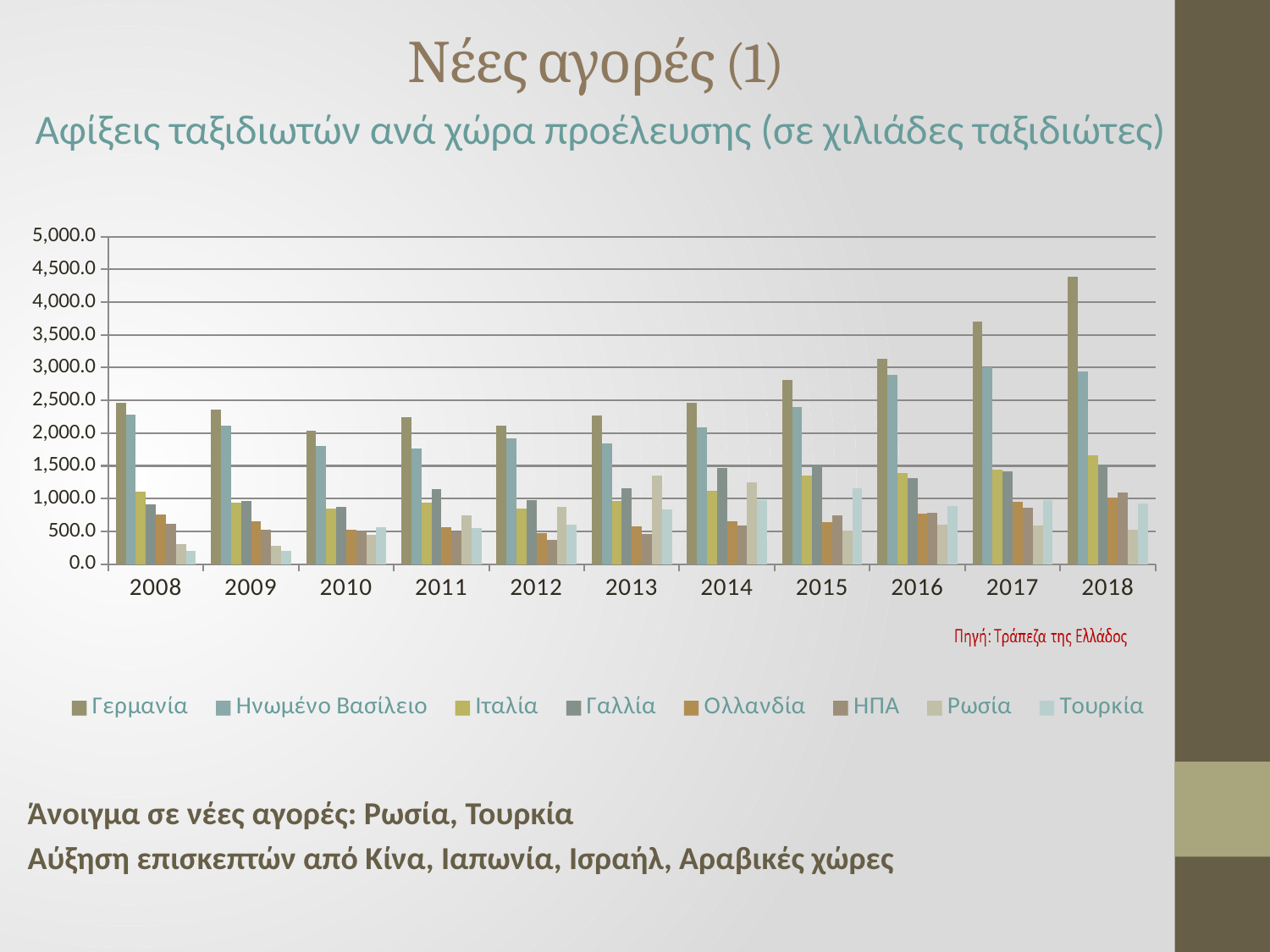
Which series has the highest value in 2018? Γερμανία Is the value for Γερμανία in 2010 greater or less than 2,500.0? less How many years are shown on the x axis? 11 Which is larger in 2013, Ρωσία or Τουρκία? Ρωσία Do the values for Γερμανία rise or fall from 2014 to 2018? rise Which is larger in 2018, Γερμανία or Ηνωμένο Βασίλειο? Γερμανία In which year is the value for Γερμανία highest? 2018 Is the value for Τουρκία in 2008 greater or less than 500.0? less How many series does the legend list? 8 Is the value for Ηνωμένο Βασίλειο in 2017 greater or less than 2,500.0? greater What kind of chart is shown on the slide? bar chart